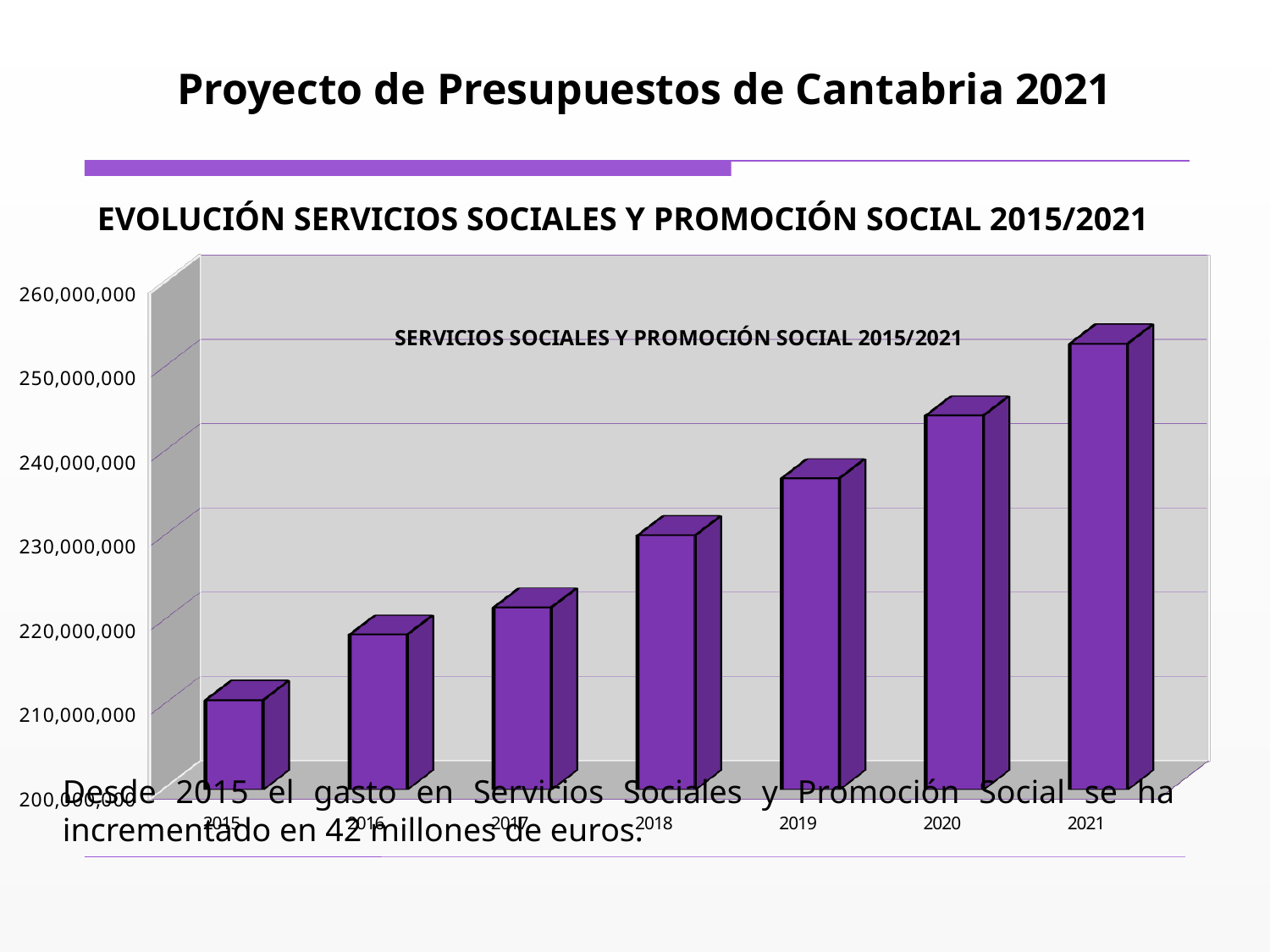
Which year has the highest value in the chart? 2021 Do the values rise or fall from 2015 to 2021? rise What colour are the bars in the chart? purple Is the value for 2020 greater or less than 240,000,000? greater Is the value for 2015 greater or less than 220,000,000? less Is the value for 2021 greater or less than 250,000,000? greater What kind of chart is shown on the slide? bar chart What is the title shown inside the chart's plot area? SERVICIOS SOCIALES Y PROMOCIÓN SOCIAL 2015/2021 How many years are plotted on the x axis of the chart? 7 Which is larger, the value for 2018 or the value for 2020? 2020 Which year has the lowest value in the chart? 2015